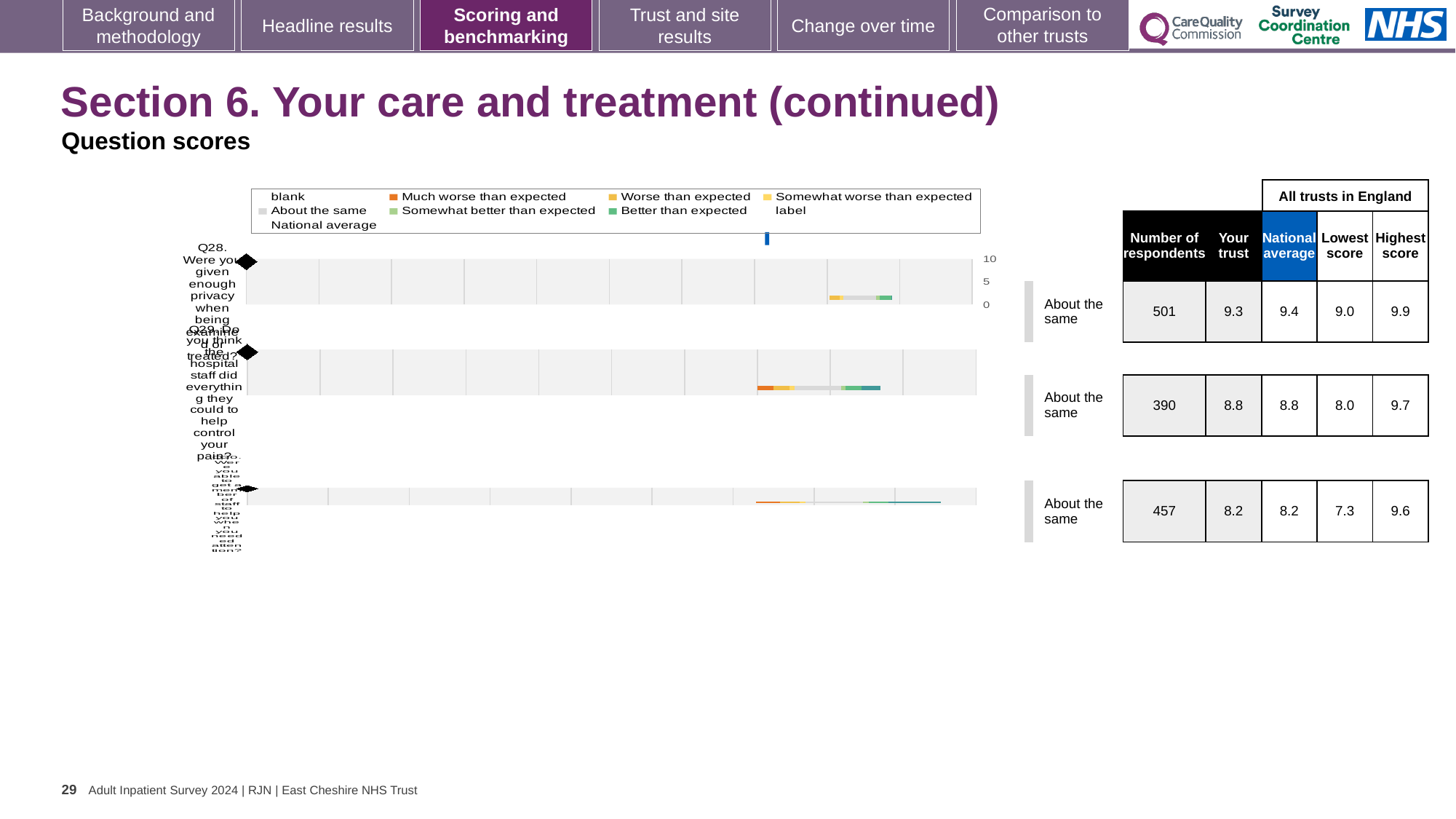
How many survey questions are plotted in the chart? 3 What type of chart is used to show the question scores on this slide? bar chart Which question has the lowest 'Your trust' score? Q30 What is the 'Your trust' score for Q28 (Were you given enough privacy when being examined or treated?)? 9.3 Is the 'Your trust' score for Q28 greater or less than 5 on the chart axis? greater Which question has the highest 'Your trust' score? Q28 Which is larger: the 'Your trust' score for Q28 or for Q29? Q28 What is the national average score for Q30? 8.2 What benchmark category is shown next to the bar for Q28? About the same What is the 'Your trust' score for Q29 (Do you think the hospital staff did everything they could to help control your pain?)? 8.8 How many respondents answered Q29? 390 What is the difference between the highest score and the lowest score across all trusts in England for Q30? 2.3